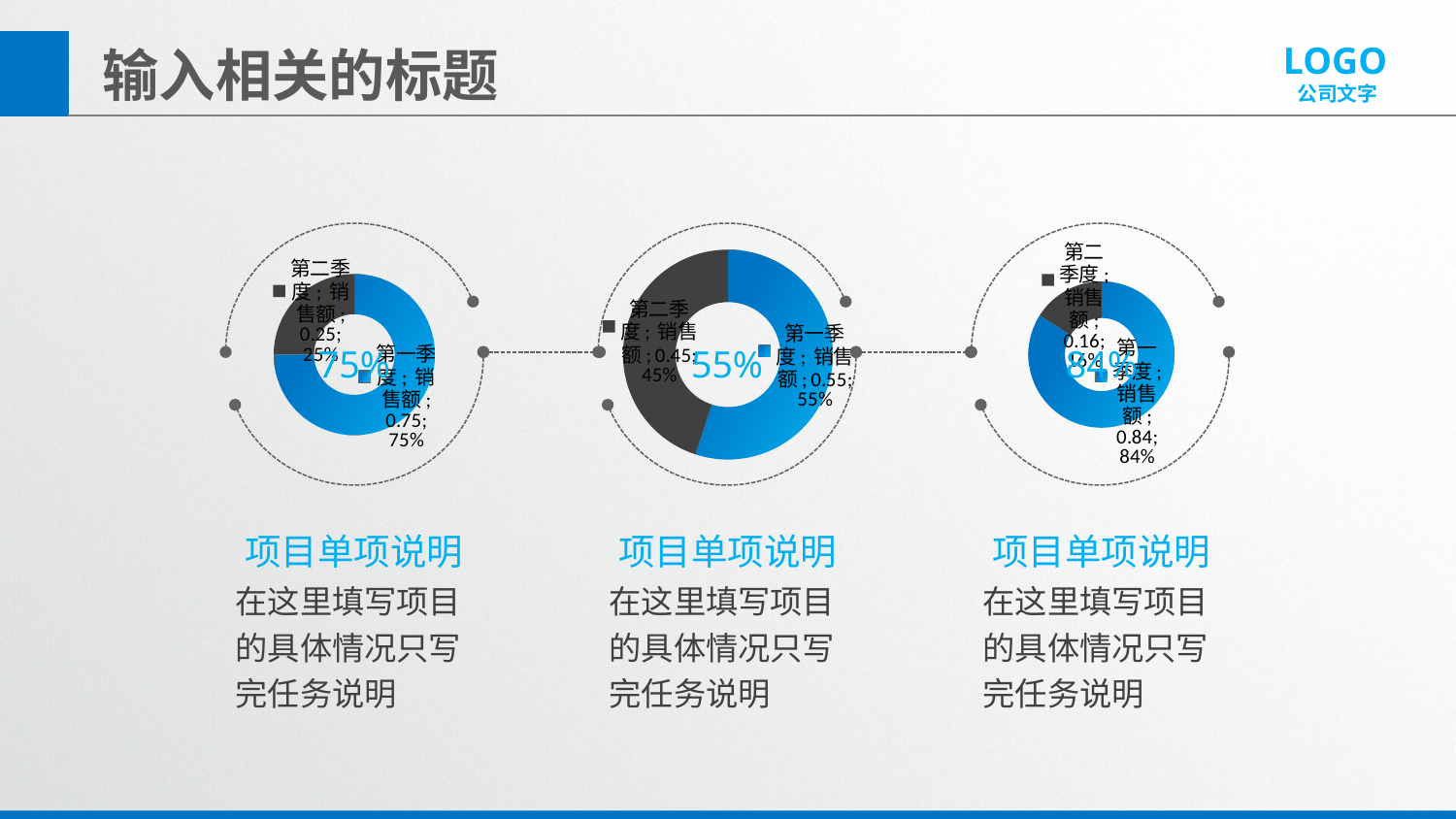
What large percentage is printed in the centre of the left doughnut chart? 75% In the left doughnut chart, what is the value shown for 第一季度 销售额? 0.75; 75% In the middle doughnut chart, what is the difference in percentage points between 第一季度 (55%) and 第二季度 (45%)? 10 In the middle doughnut chart, what percentage is shown for 第一季度 销售额? 55% How many slices does the right doughnut chart have? 2 In the middle doughnut chart, what value is shown for 第二季度 销售额? 0.45; 45% In the left doughnut chart, which slice is larger, 第一季度 or 第二季度? 第一季度 In the right doughnut chart, what percentage is shown for 第二季度 销售额? 16% In the right doughnut chart, what percentage is shown for 第一季度 销售额? 84% What type of chart is used in the middle of the slide? Doughnut chart In the left doughnut chart, what percentage is shown for 第二季度 销售额? 25% In the right doughnut chart, which slice is the smallest? 第二季度